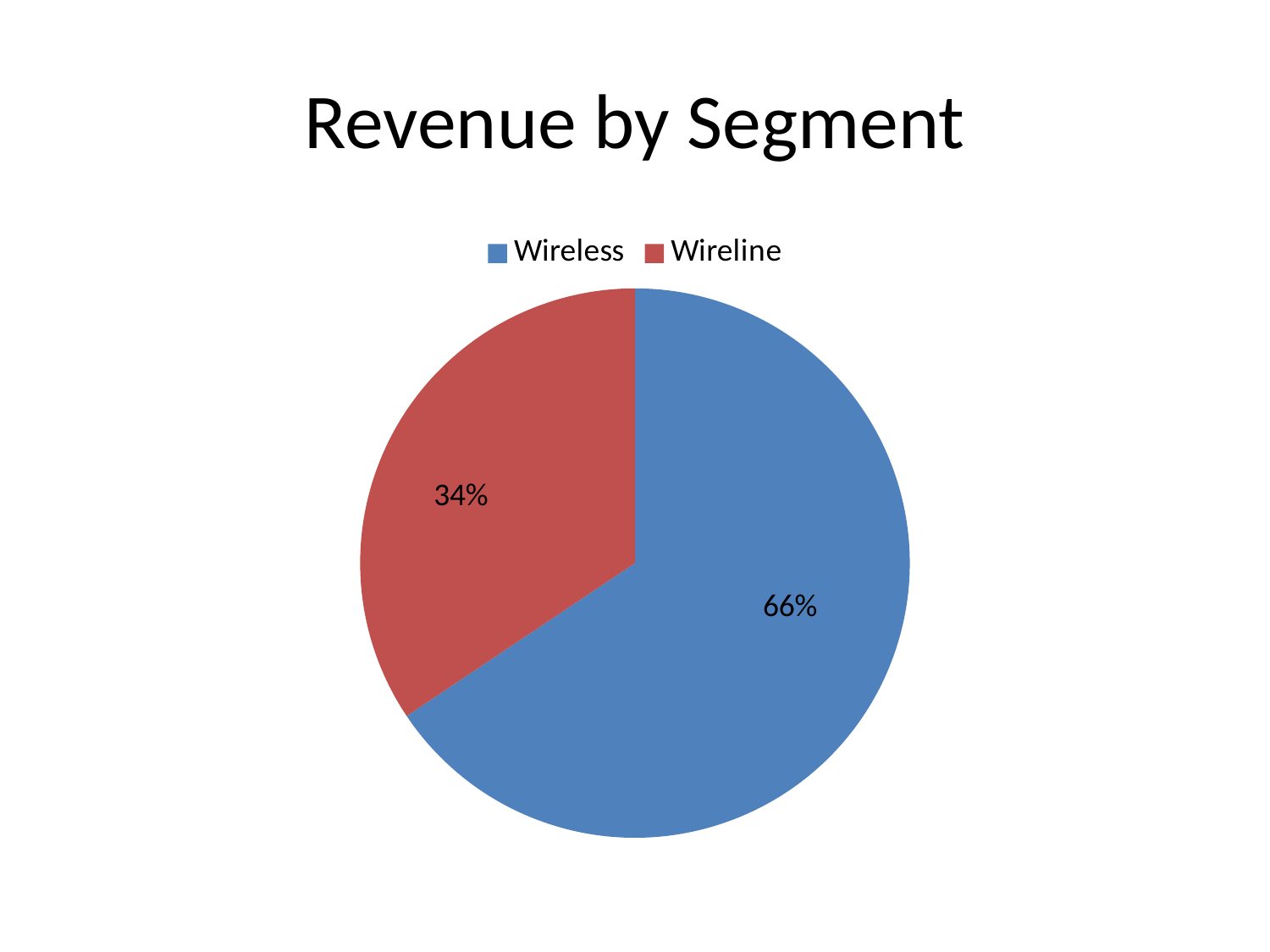
What is the title of the chart? Revenue by Segment Which segment has the largest share of revenue? Wireless How many segments are shown in the pie chart? 2 Which segment has the smallest share of revenue? Wireline What share of revenue does the Wireless segment account for? 66% What is the difference in percentage points between the Wireless and Wireline shares? 32 How many entries does the legend list? 2 Which segment has the larger share, Wireless or Wireline? Wireless What share of revenue does the Wireline segment account for? 34% What colour represents the Wireline segment? Red What kind of chart is shown on the slide? Pie chart